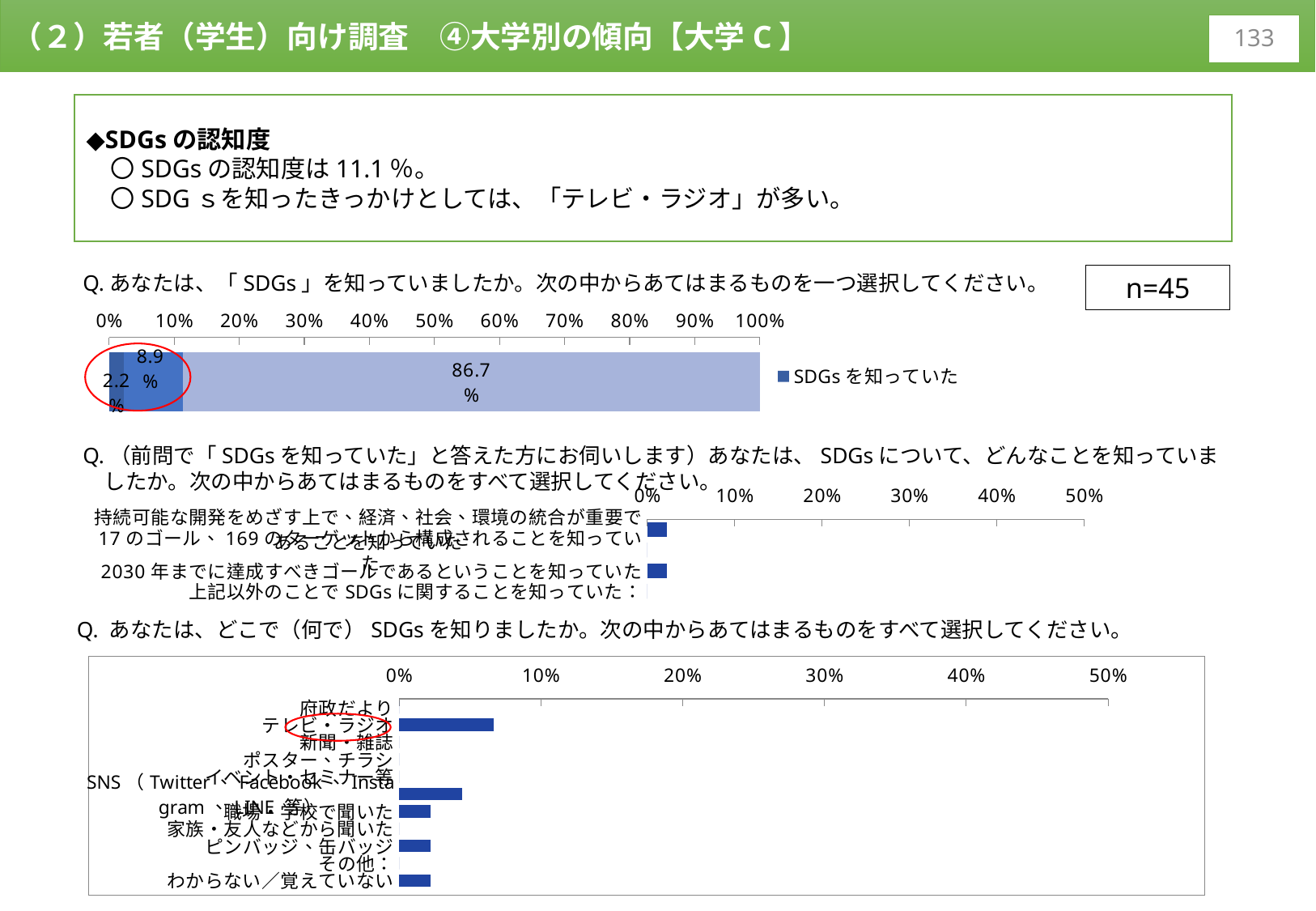
In the bottom chart (どこで（何で）SDGsを知りましたか), is the value for テレビ・ラジオ greater or less than 10%? less In the middle chart (SDGsについて、どんなことを知っていましたか), is the value for 2030年までに達成すべきゴールであるということを知っていた greater or less than 10%? less In the bottom chart (どこで（何で）SDGsを知りましたか), which category has the longest bar? テレビ・ラジオ In the top stacked bar chart, what is the value of the smallest segment? 2.2% What kind of chart is the bottom chart (どこで（何で）SDGsを知りましたか)? bar chart In the bottom chart (どこで（何で）SDGsを知りましたか), which is larger: テレビ・ラジオ or 職場・学校で聞いた? テレビ・ラジオ In the top stacked bar chart, what is the difference between the 86.7% segment and the 8.9% segment? 77.8% In the top stacked bar chart, what is the value of the largest segment? 86.7% What kind of chart is the top chart next to the n=45 box? bar chart In the top stacked bar chart, what is the total of the three labelled segments? 97.8% What legend entry is shown to the right of the top stacked bar chart? SDGsを知っていた In the top stacked bar chart, what is the difference between the 8.9% segment and the 2.2% segment? 6.7%